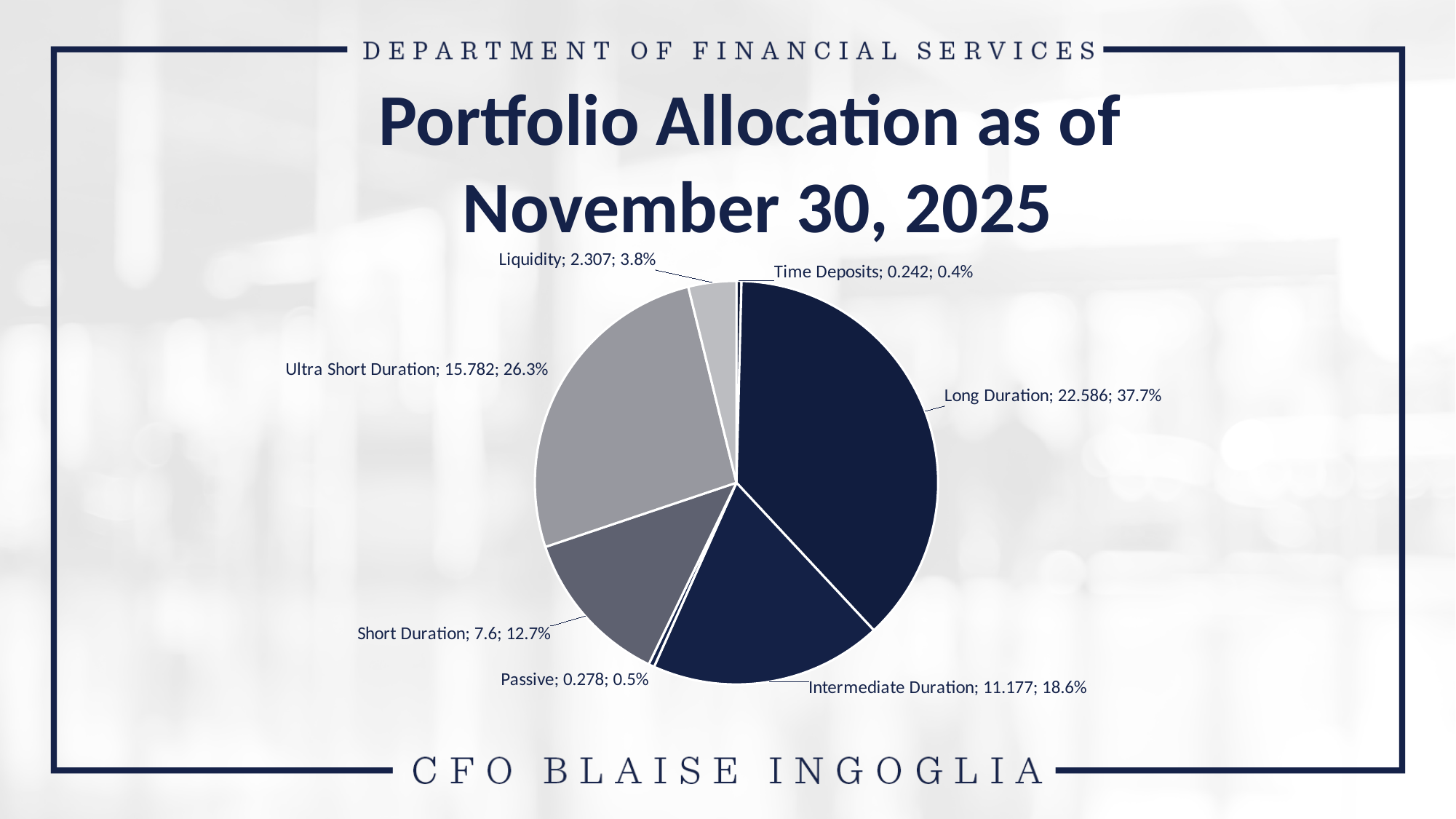
Which is larger, the value for Short Duration or the value for Liquidity? Short Duration What is the value shown for Intermediate Duration? 11.177 How many categories are shown in the pie chart? 7 What type of chart is shown on the slide? Pie chart What is the value shown for Long Duration? 22.586 Which category has the largest slice of the pie? Long Duration What is the value shown for Short Duration? 7.6 What percentage share does Ultra Short Duration have? 26.3% What percentage share does Passive have? 0.5% What is the difference between the values for Long Duration and Intermediate Duration? 11.409 What is the title of the chart on the slide? Portfolio Allocation as of November 30, 2025 Which category has the smallest slice of the pie? Time Deposits